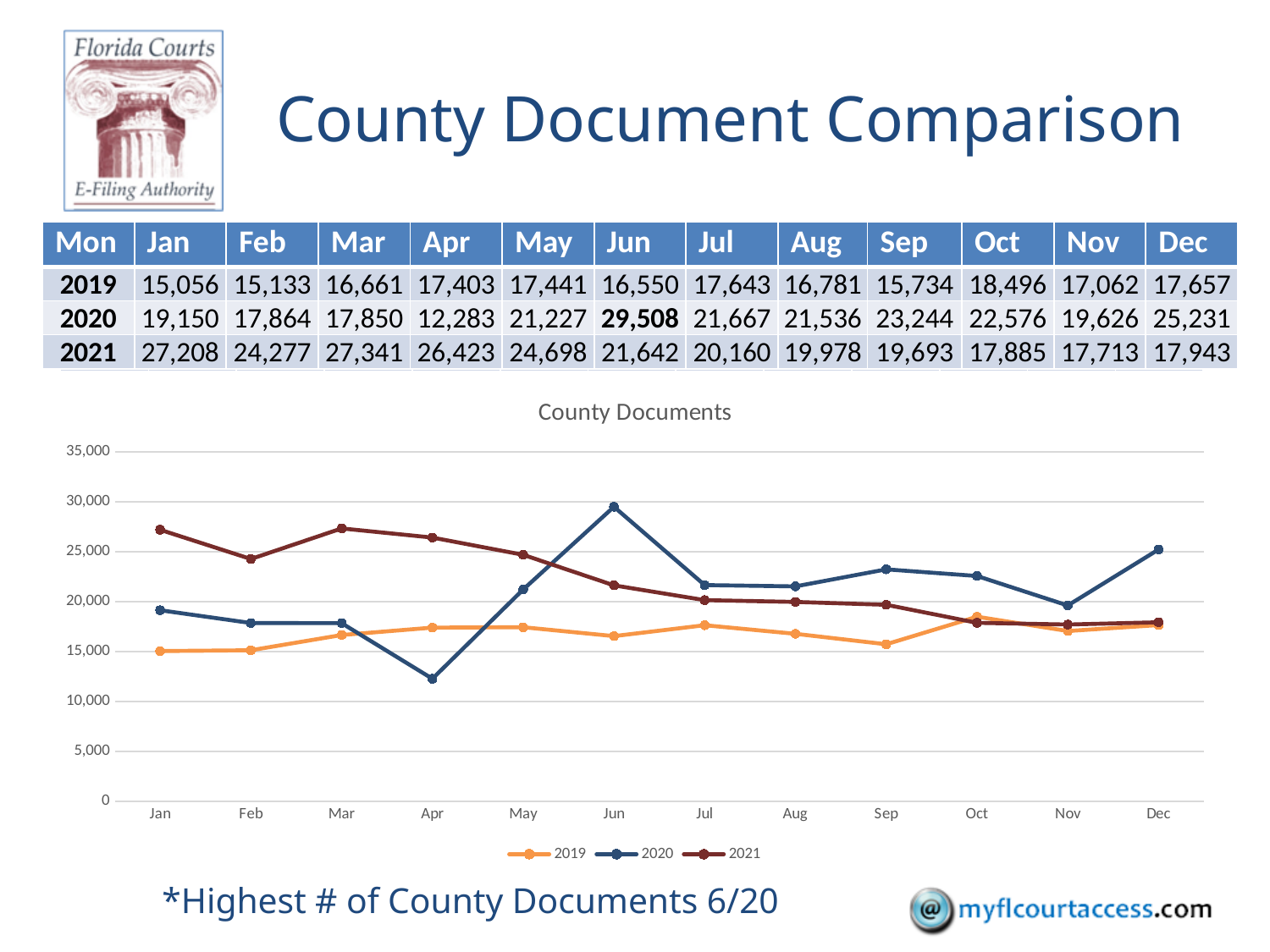
Does the 2021 series generally rise or fall from Jan to Dec? fall How many months are plotted along the x axis? 12 What is the title of the chart? County Documents What is the value for 2021 in Jan? 27,208 In which month does the 2020 series reach its highest value? Jun What is the value for 2020 in Jun? 29,508 Is the value for 2019 in Sep greater or less than 20,000? less How many series does the legend list? 3 Which series has the larger value in Dec, 2020 or 2021? 2020 What kind of chart is shown on the slide? line chart What is the difference between the Jan values for 2021 and 2019? 12,152 In which month does the 2020 series reach its lowest value? Apr